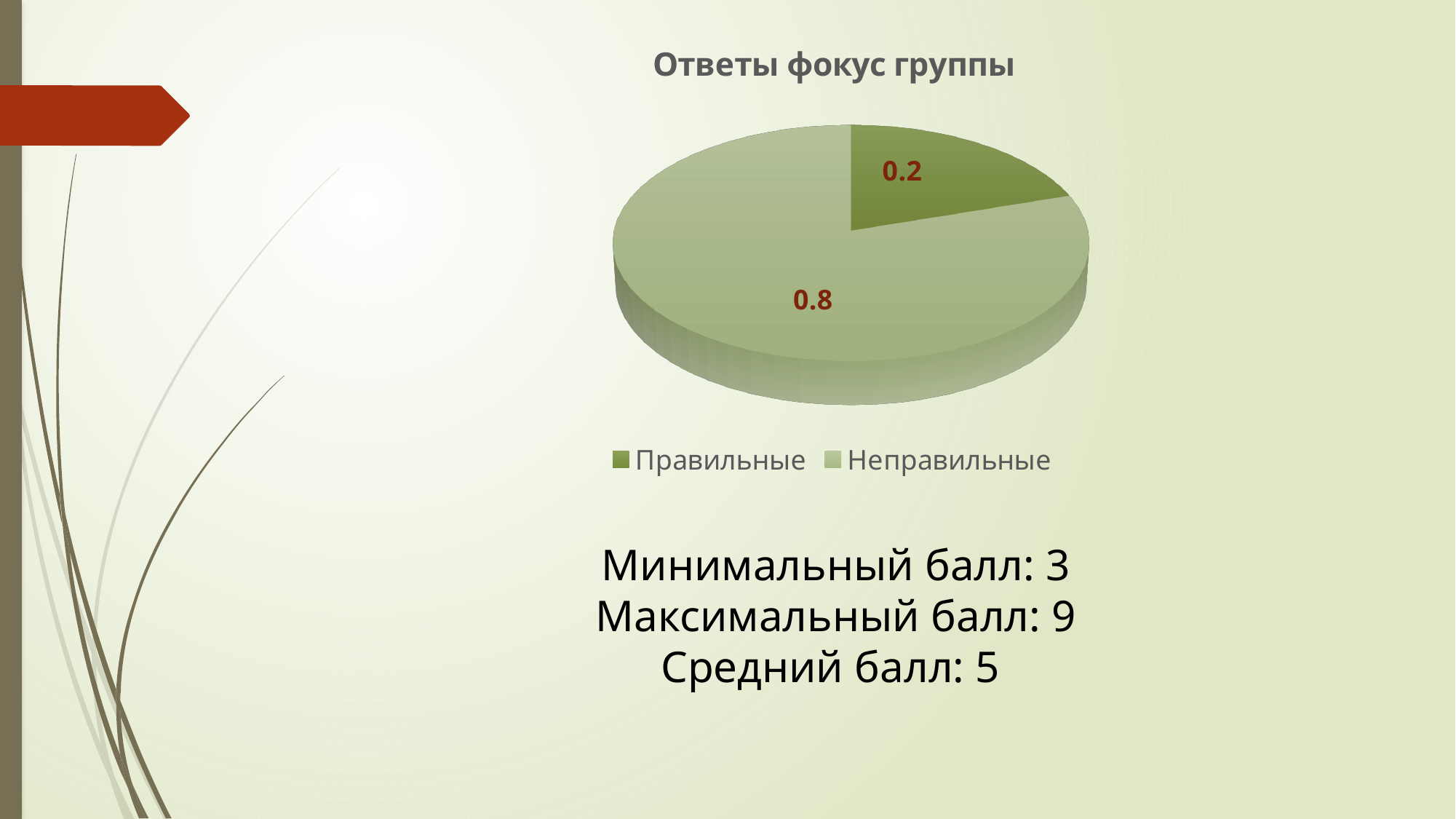
What is the title of the chart? Ответы фокус группы What is the value for Неправильные in the pie chart? 0.8 Which category has the smallest slice in the pie chart? Правильные Which category has the largest slice in the pie chart? Неправильные How many slices does the pie chart have? 2 What is the value for Правильные in the pie chart? 0.2 Which is larger, the value for Правильные or the value for Неправильные? Неправильные What is the difference between the values for Неправильные and Правильные? 0.6 Which legend entry is shown with the darker green colour? Правильные What share of the pie does the Правильные slice represent? 20% What kind of chart is shown on the slide? Pie chart How many entries does the legend list? 2